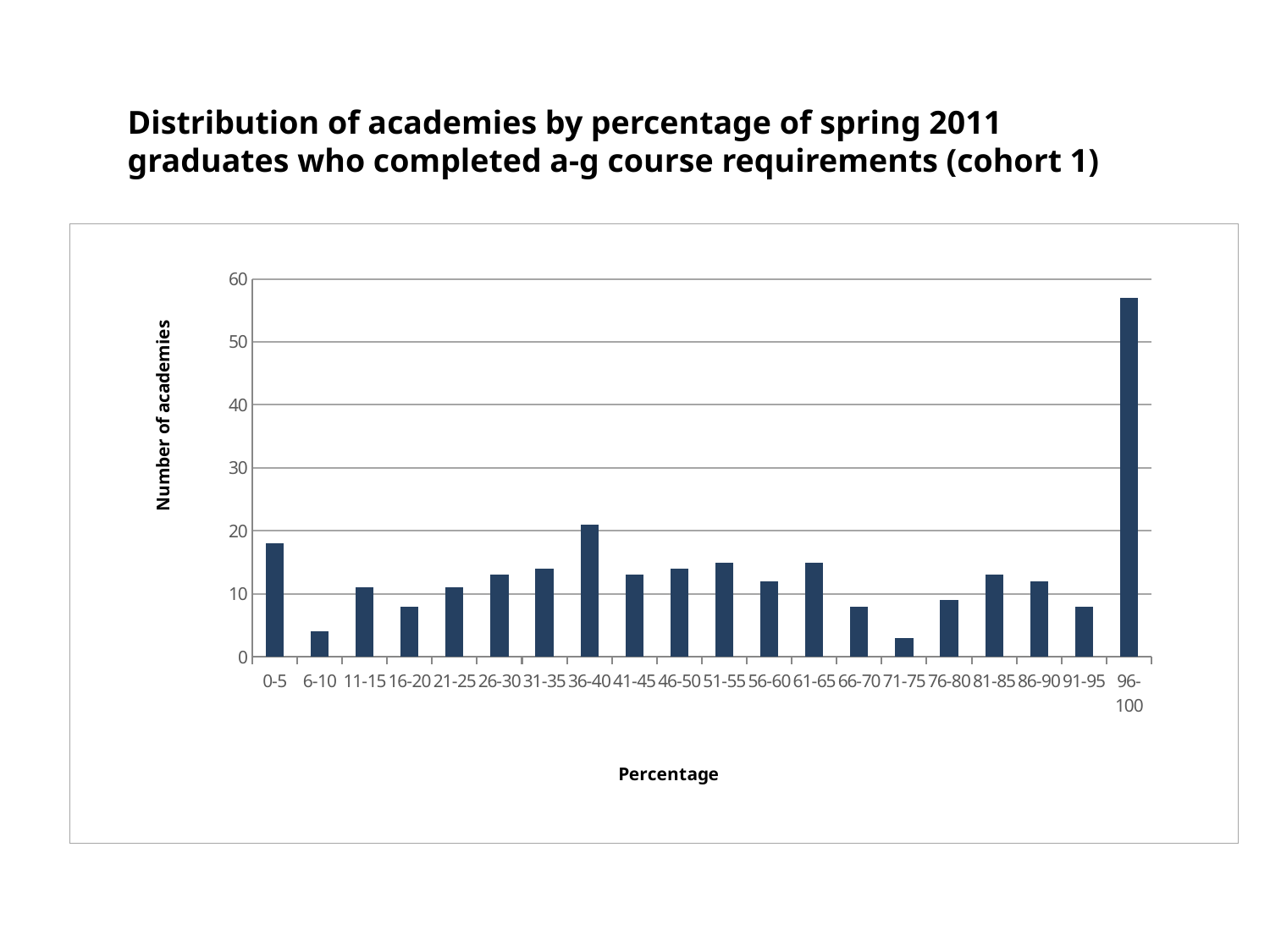
Is the number of academies for the 0-5 range greater or less than 20? less What is the label of the x axis? Percentage Is the number of academies for the 96-100 range greater or less than 50? greater Is the number of academies for the 71-75 range greater or less than 10? less Which has more academies, the 0-5 range or the 6-10 range? 0-5 Which percentage range has the highest number of academies? 96-100 What kind of chart is shown on the slide? bar chart Which has more academies, the 96-100 range or the 36-40 range? 96-100 What is the label of the y axis? Number of academies How many percentage ranges are shown on the x axis? 20